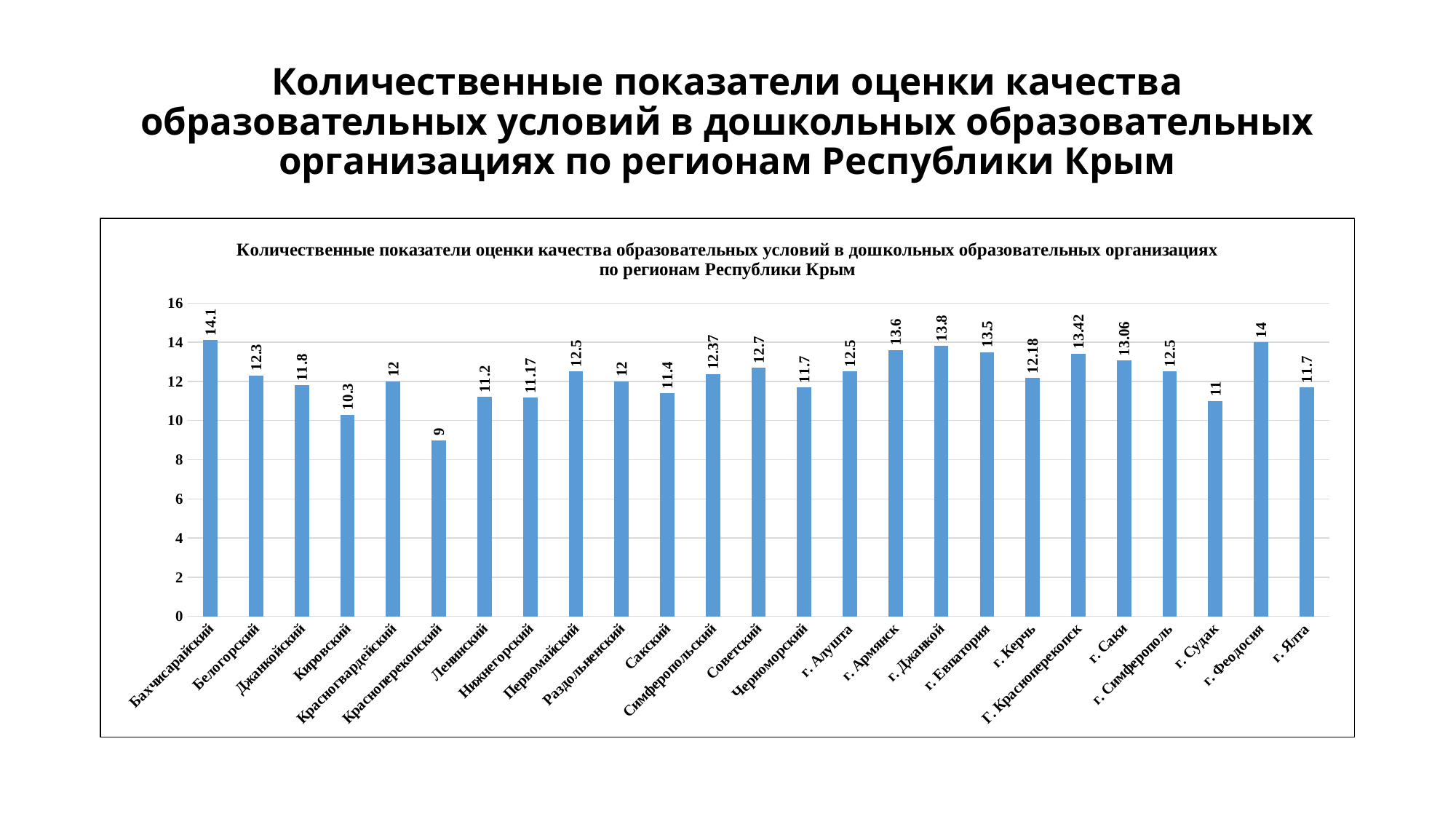
What is the value for г. Красноперекопск? 13.42 Which region has the highest value? Бахчисарайский Which has a larger value, г. Армянск or г. Евпатория? г. Армянск How many regions are shown on the chart? 25 What colour are the bars in the chart? blue Which region has the lowest value? Красноперекопский What is the difference between the values for г. Феодосия and г. Ялта? 2.3 What is the value for Бахчисарайский? 14.1 What kind of chart is shown on the slide? bar chart What is the difference between the values for г. Джанкой and г. Судак? 2.8 Is the value for Кировский greater or less than 12? less What is the value for Нижнегорский? 11.17